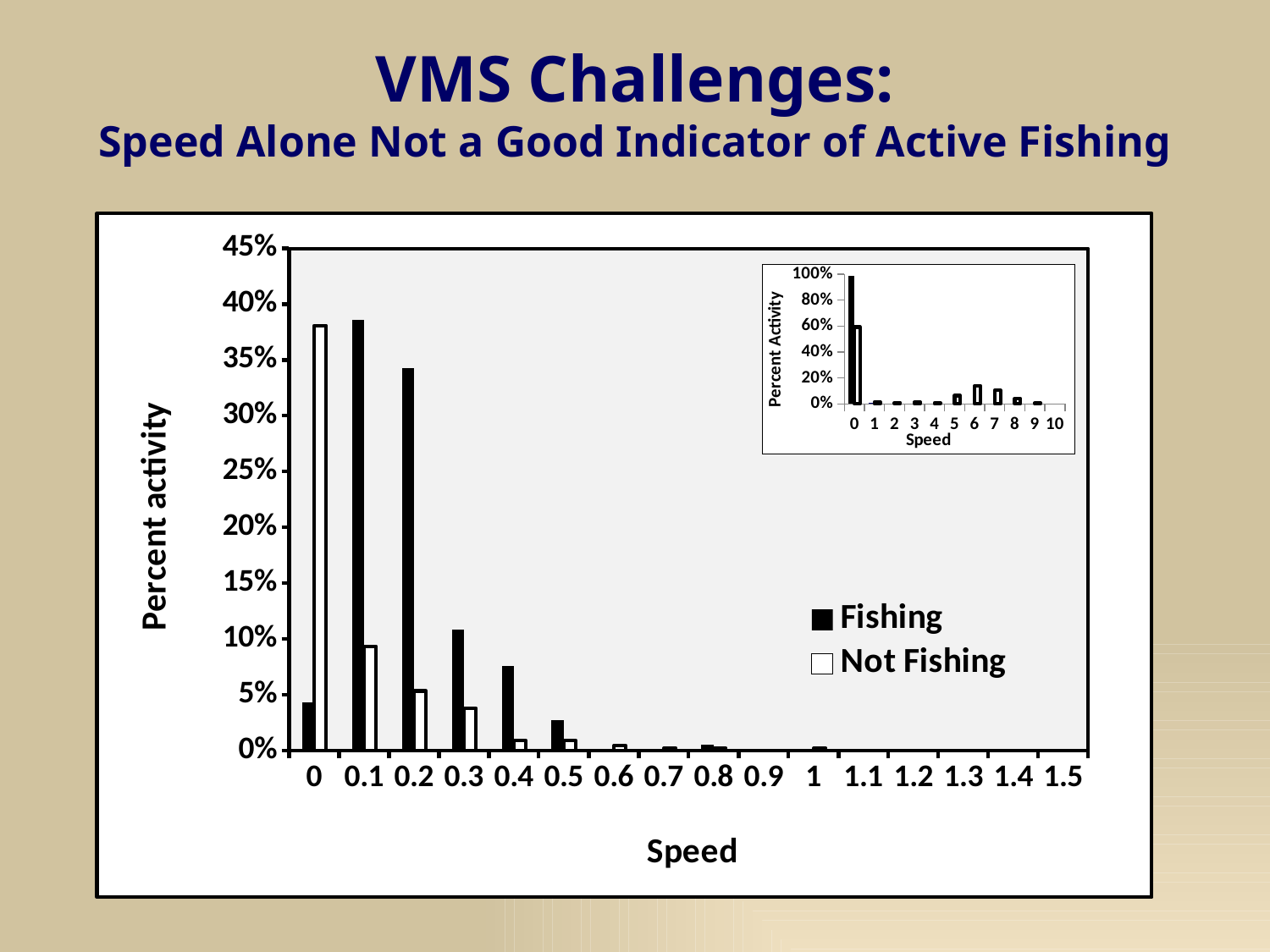
In the main chart, is the Fishing value at speed 0.4 greater or less than 10%? less In the main chart, how many speed categories are shown on the x axis? 16 In the main chart, at speed 0, which series has the larger value, Fishing or Not Fishing? Not Fishing In the main chart, at which speed is the Not Fishing series highest? 0 In the main chart, do the Fishing values rise or fall as speed increases from 0.1 to 1.5? fall In the main chart, how many series does the legend list? 2 What kind of chart is the main chart on the slide? bar chart In the main chart, at which speed is the Fishing series highest? 0.1 In the main chart, at speed 0.1, which series has the larger value, Fishing or Not Fishing? Fishing In the inset chart in the upper right, is the Fishing value at speed 0 greater or less than 80%? greater In the main chart, is the Fishing value at speed 0.1 greater or less than 35%? greater In the main chart, what are the two legend entries? Fishing and Not Fishing